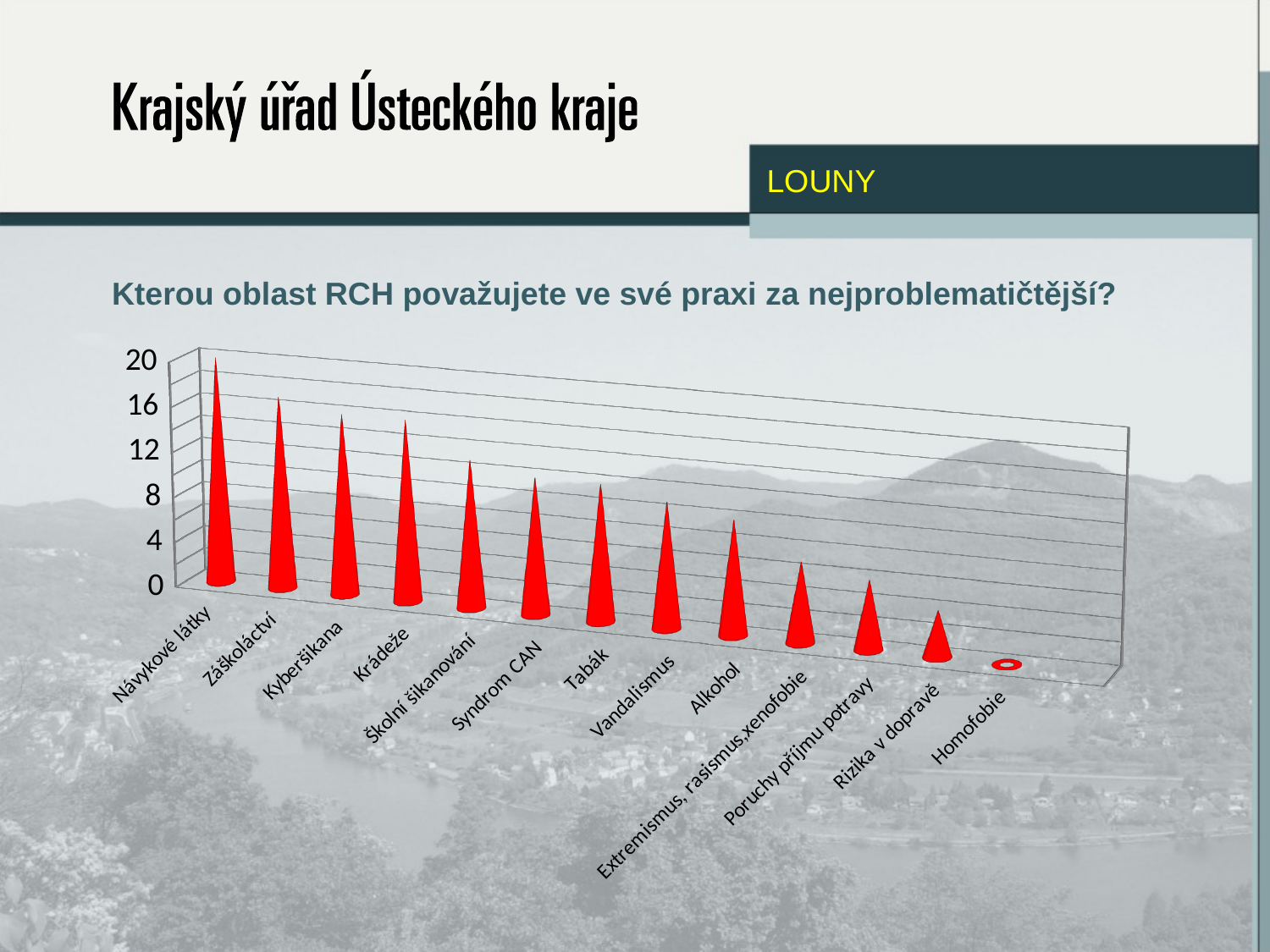
Is the value for Návykové látky greater or less than 16? greater Which category has the highest value in the chart? Návykové látky What is the value for Homofobie? 0 What is the title of the chart? Kterou oblast RCH považujete ve své praxi za nejproblematičtější? What kind of chart is shown on the slide? bar chart Which category has the lowest value in the chart? Homofobie Do the values rise or fall from left to right along the x axis? fall What colour are the bars in the chart? red Is the value for Alkohol greater or less than 12? less How many categories are shown on the x axis of the chart? 13 Which is larger, the value for Záškoláctví or the value for Vandalismus? Záškoláctví